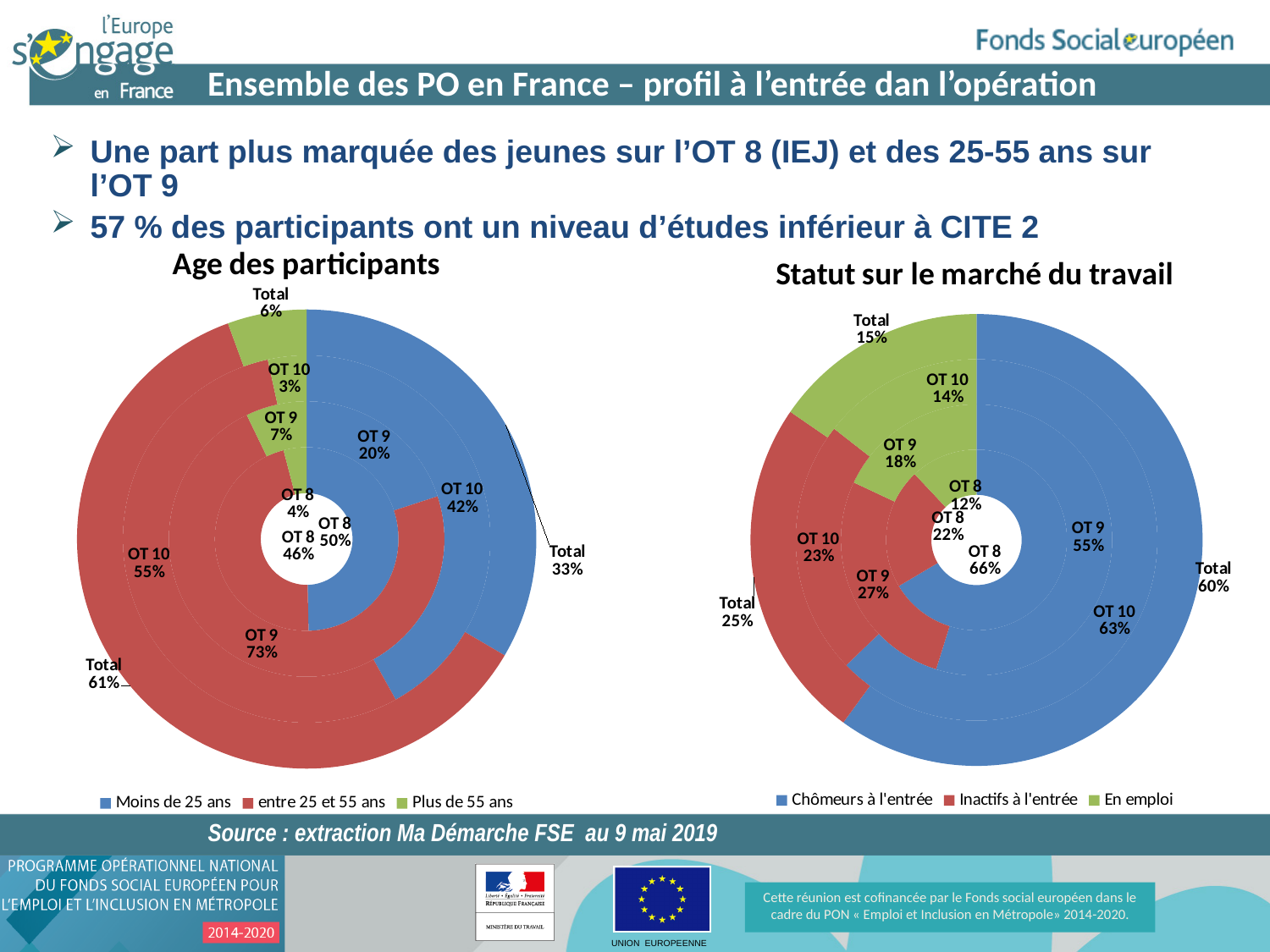
What type of chart is 'Statut sur le marché du travail'? Doughnut chart How many series does the legend of the 'Age des participants' chart list? 3 In the 'Statut sur le marché du travail' chart, which OT has the lowest 'Chômeurs à l'entrée' share? OT 9 In the 'Statut sur le marché du travail' chart, what is the 'Chômeurs à l'entrée' share for OT 8? 66% In the 'Statut sur le marché du travail' chart, what is the difference between the 'En emploi' shares of OT 9 and OT 8? 6% In the 'Age des participants' chart, what share of the Total ring is 'Moins de 25 ans'? 33% In the 'Age des participants' chart, what is the 'entre 25 et 55 ans' share for OT 9? 73% In the 'Statut sur le marché du travail' chart, what is the 'En emploi' share in the Total ring? 15% In the 'Statut sur le marché du travail' chart, is the 'Inactifs à l'entrée' share larger for OT 9 or OT 10? OT 9 In the 'Age des participants' chart, which OT has the highest 'Moins de 25 ans' share? OT 8 In the 'Age des participants' chart, what is the 'Plus de 55 ans' share for OT 10? 3% In the 'Age des participants' chart, what is the difference between the 'entre 25 et 55 ans' shares of OT 9 and OT 8? 27%